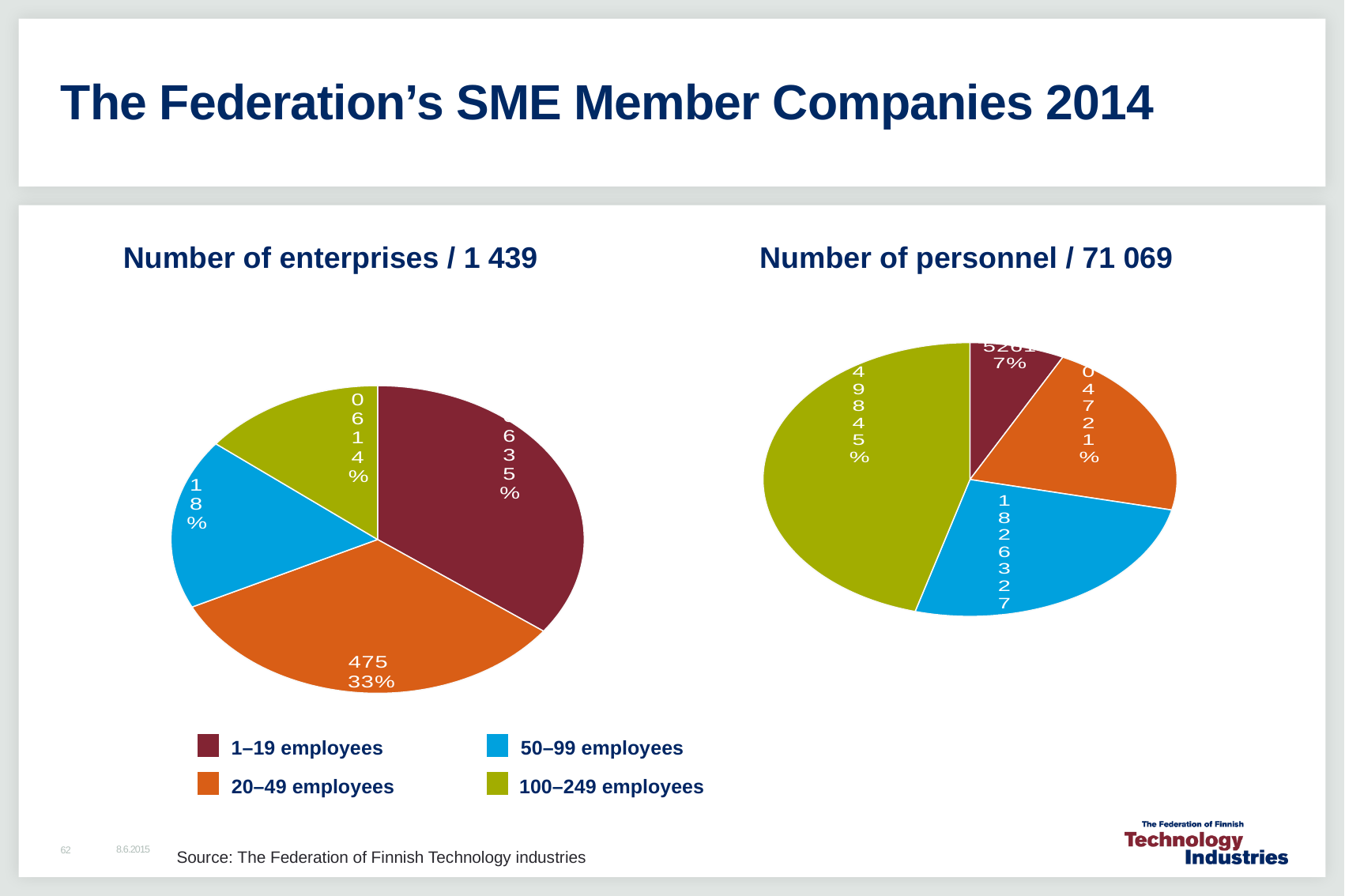
In the Number of enterprises / 1 439 chart, which size class has the smallest slice? 100–249 employees In the Number of enterprises / 1 439 chart, what share of enterprises have 20–49 employees? 33% How many size classes does the legend list? 4 In the Number of enterprises / 1 439 chart, what share of enterprises have 100–249 employees? 14% In the Number of enterprises / 1 439 chart, what share of enterprises have 50–99 employees? 18% In the Number of personnel / 71 069 chart, which size class has the smallest slice? 1–19 employees In the Number of personnel / 71 069 chart, which size class has the largest slice? 100–249 employees What kind of chart is used for the Number of enterprises / 1 439 chart? Pie chart In the Number of enterprises / 1 439 chart, how many enterprises have 20–49 employees? 475 In the Number of personnel / 71 069 chart, how many personnel are in companies with 1–19 employees? 5261 In the Number of personnel / 71 069 chart, which slice is larger: 50–99 employees or 20–49 employees? 50–99 employees